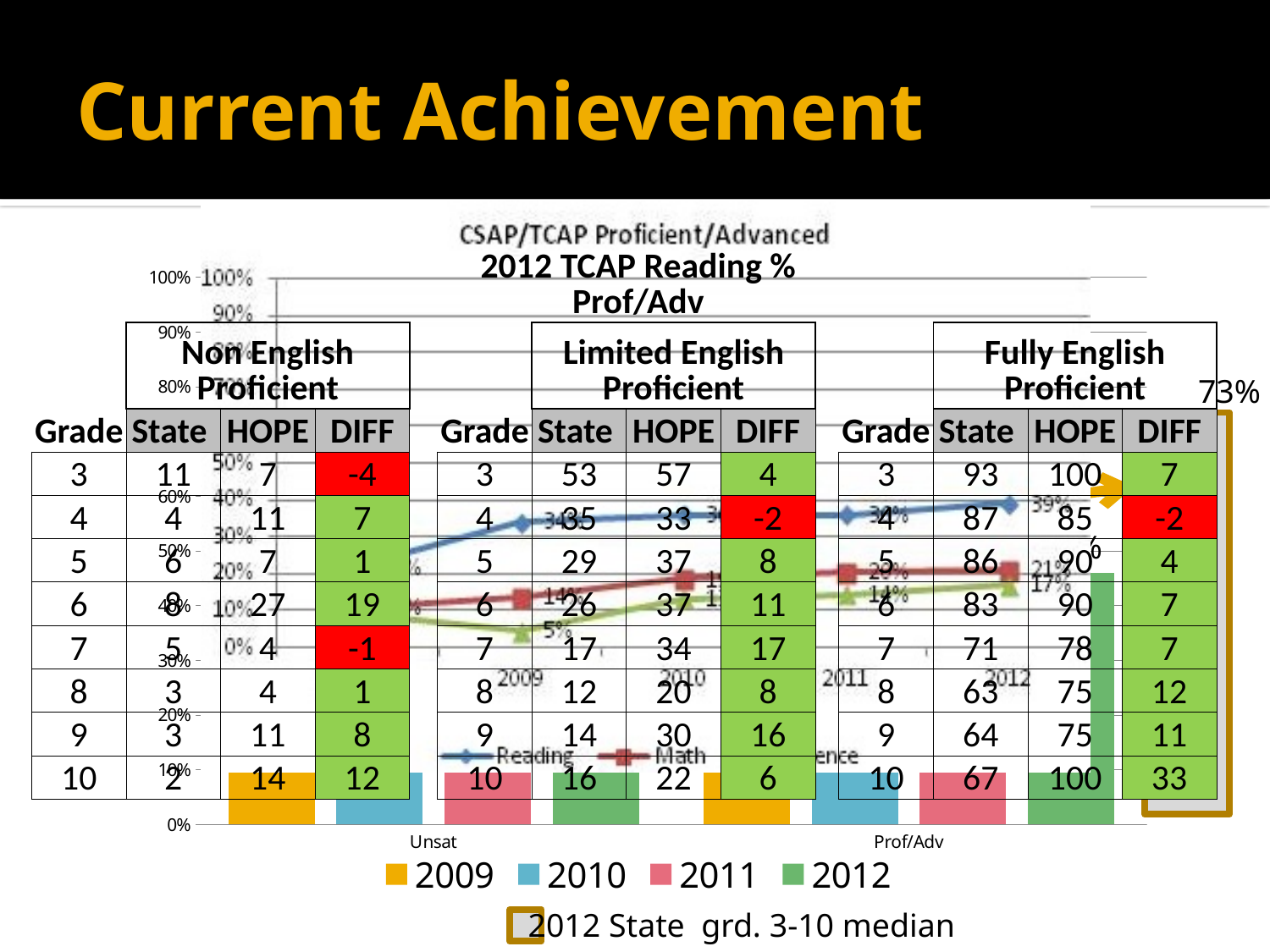
In the bar chart at the bottom of the slide, which is larger: the 2012 bar for Prof/Adv or the 2012 bar for Unsat? Prof/Adv How many series does the legend of the bar chart at the bottom of the slide list? 4 Which years are listed in the legend of the bar chart at the bottom of the slide? 2009, 2010, 2011, 2012 What is the title of the line chart overlaid in the middle of the slide? CSAP/TCAP Proficient/Advanced How many categories are shown on the x axis of the bar chart at the bottom of the slide? 2 What are the two x-axis categories of the bar chart at the bottom of the slide? Unsat and Prof/Adv What kind of chart is the chart with the 2009–2012 legend at the bottom of the slide? bar chart What is the highest value shown on the left vertical axis of the bar chart at the bottom of the slide? 100% In the bar chart at the bottom of the slide, is the 2012 value for Prof/Adv greater or less than 30%? greater